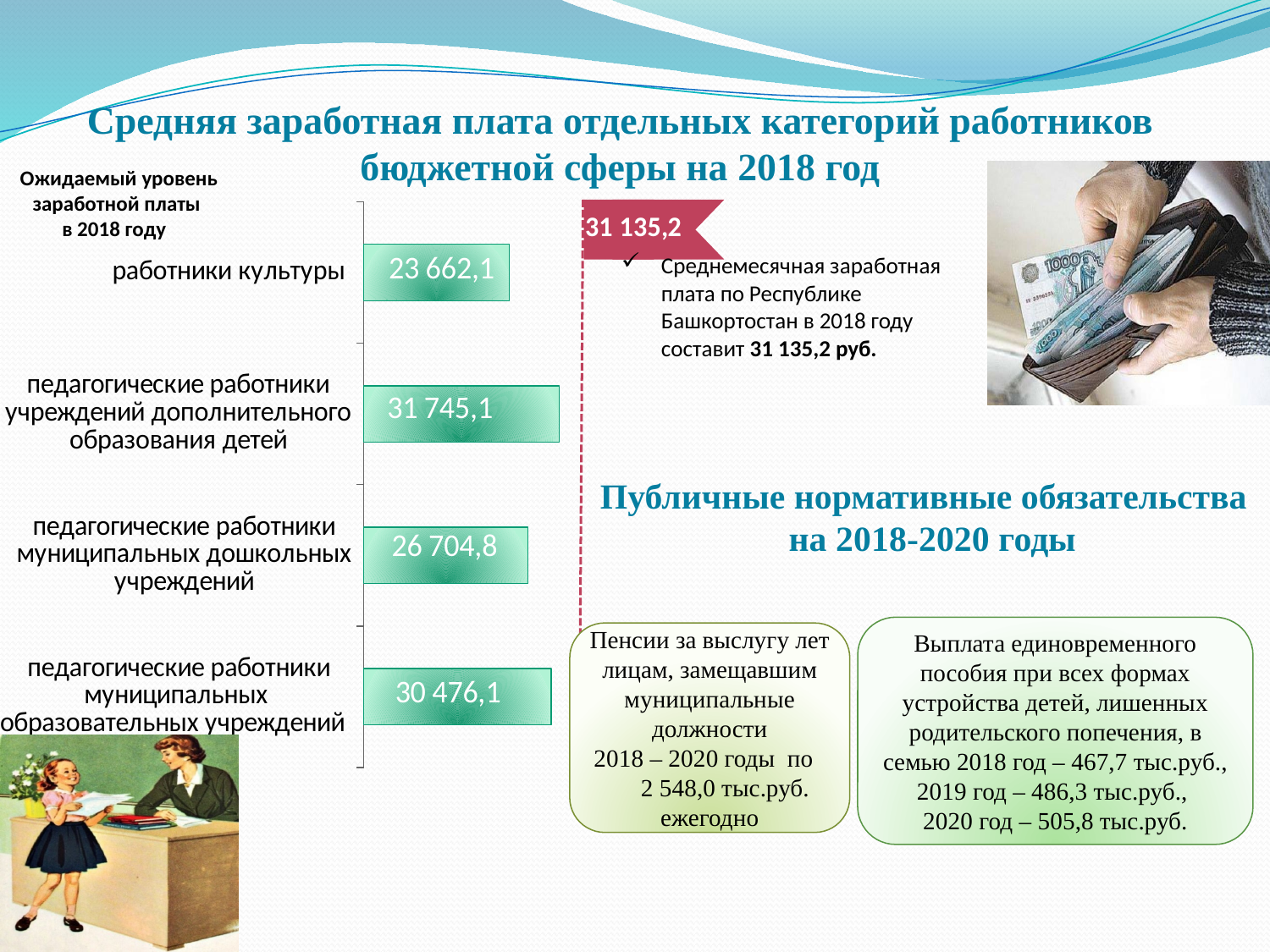
What is the expected 2018 average salary for работники культуры? 23 662,1 Which category has the lowest expected salary in the chart? работники культуры How many categories are shown in the bar chart? 4 What kind of chart is used to show the expected salary levels? bar chart What value is shown for педагогические работники муниципальных дошкольных учреждений? 26 704,8 What value is shown for педагогические работники учреждений дополнительного образования детей? 31 745,1 What is the difference between the values for педагогические работники муниципальных образовательных учреждений and педагогические работники муниципальных дошкольных учреждений? 3 771,3 What value is shown for педагогические работники муниципальных образовательных учреждений? 30 476,1 What is the difference between the values for педагогические работники учреждений дополнительного образования детей and работники культуры? 8 083,0 What reference value is marked on the chart for the average monthly salary in the Republic of Bashkortostan in 2018? 31 135,2 Which category has the highest expected salary in the chart? педагогические работники учреждений дополнительного образования детей Which is larger: the value for педагогические работники муниципальных дошкольных учреждений or for работники культуры? педагогические работники муниципальных дошкольных учреждений